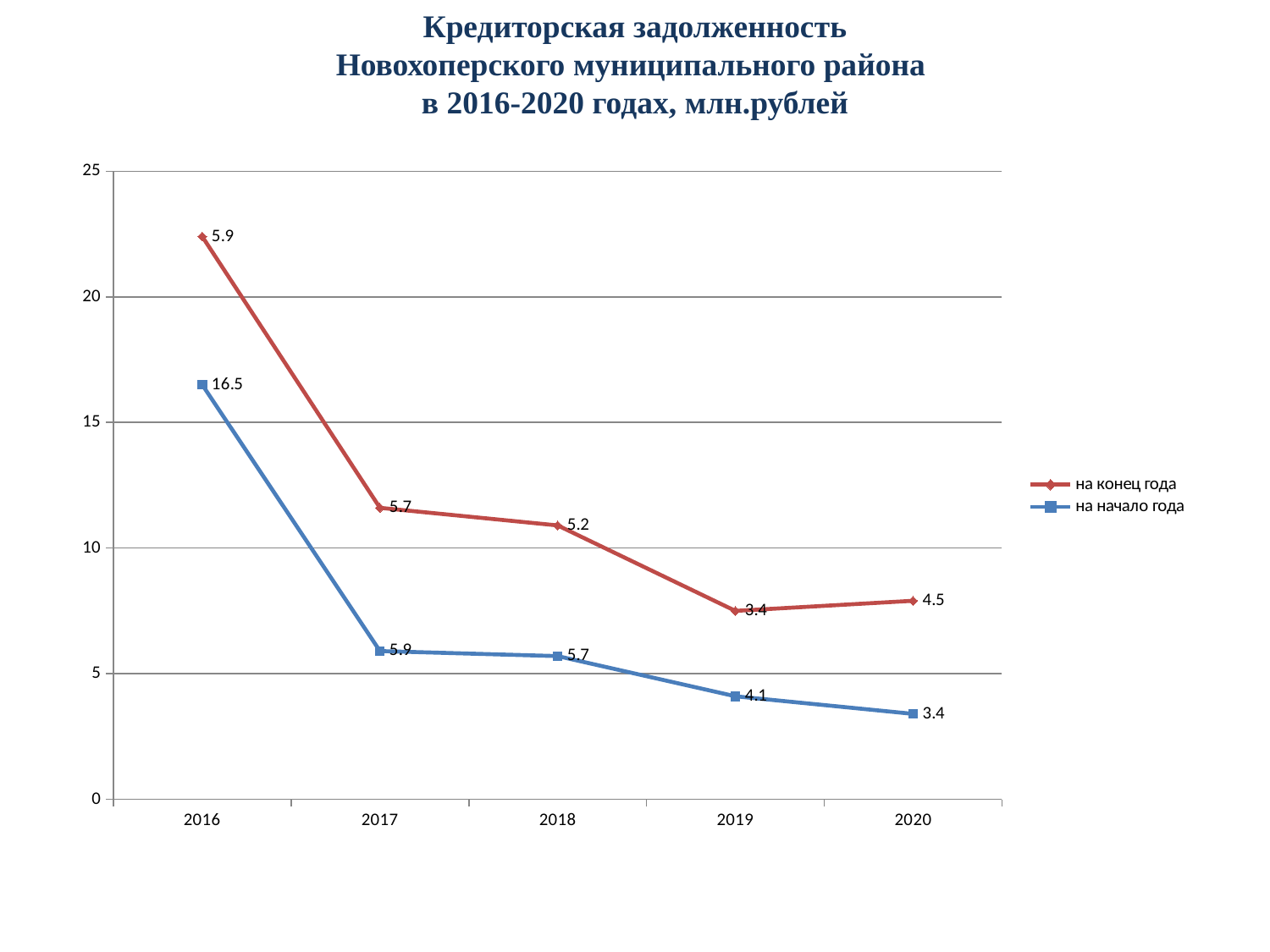
What is the value for 2018 in the "на конец года" series? 5.2 What is the value for 2016 in the "на начало года" series? 16.5 Does the "на начало года" series rise or fall from 2016 to 2020? fall How many series does the legend list? 2 Which year has the highest value in the "на начало года" series? 2016 What is the difference between the 2016 and 2020 values in the "на начало года" series? 13.1 How many years are shown on the x axis? 5 What is the value for 2019 in the "на начало года" series? 4.1 Which year has the lowest value in the "на начало года" series? 2020 What is the value for 2020 in the "на конец года" series? 4.5 What kind of chart is shown on the slide? line chart In the "на конец года" series, which is larger: the value for 2017 or the value for 2018? 2017